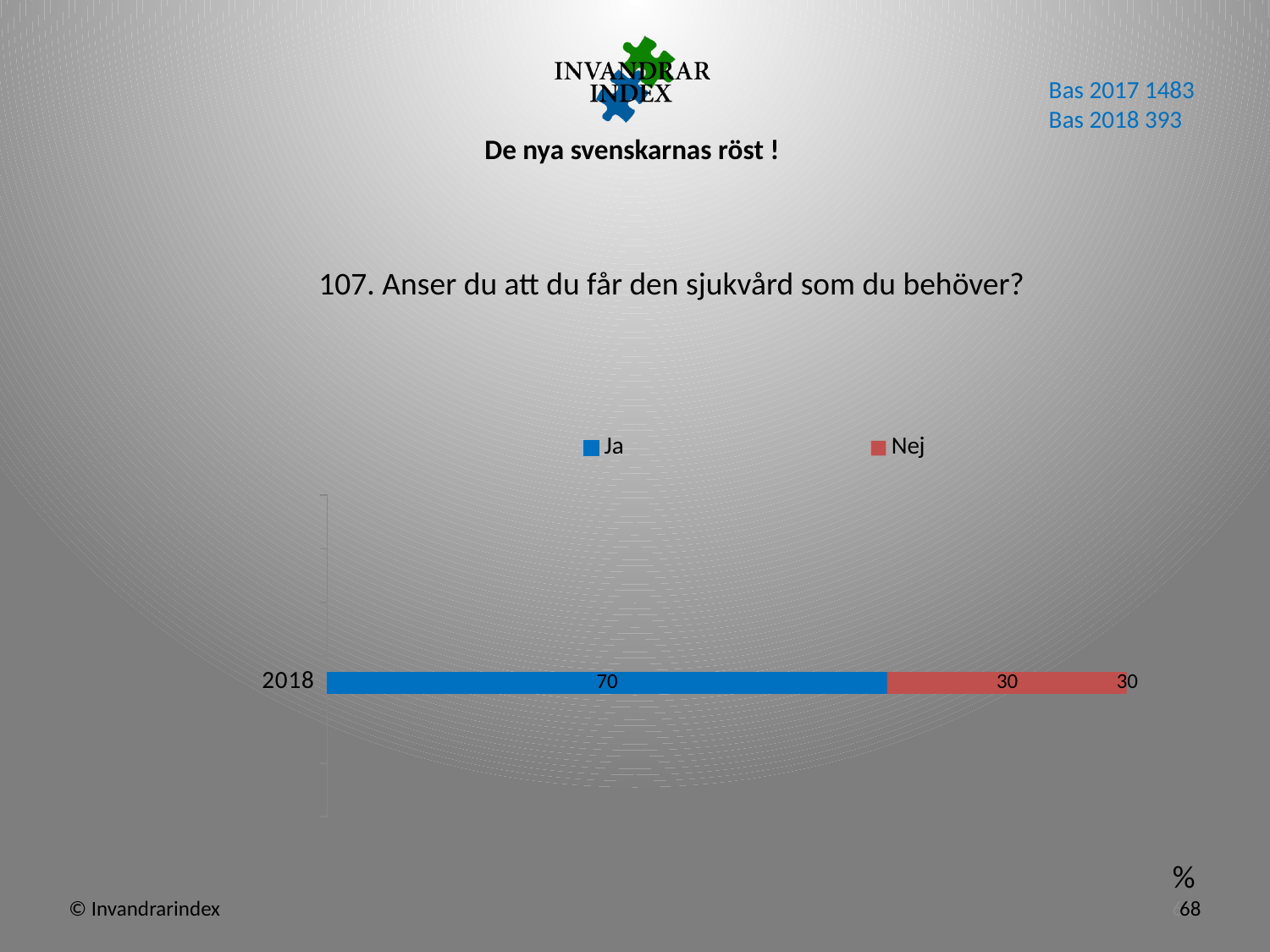
How many series does the legend list? 2 What is the value for Nej in 2018? 30 What kind of chart is shown on the slide? bar chart Which series has the higher value for 2018, Ja or Nej? Ja What colour represents the Ja series in the chart? blue What is the value for Ja in 2018? 70 Which year is shown as the category on the chart? 2018 What is the difference between the Ja and Nej values for 2018? 40 Which series has the lowest value for 2018? Nej How many categories are shown on the chart's axis? 1